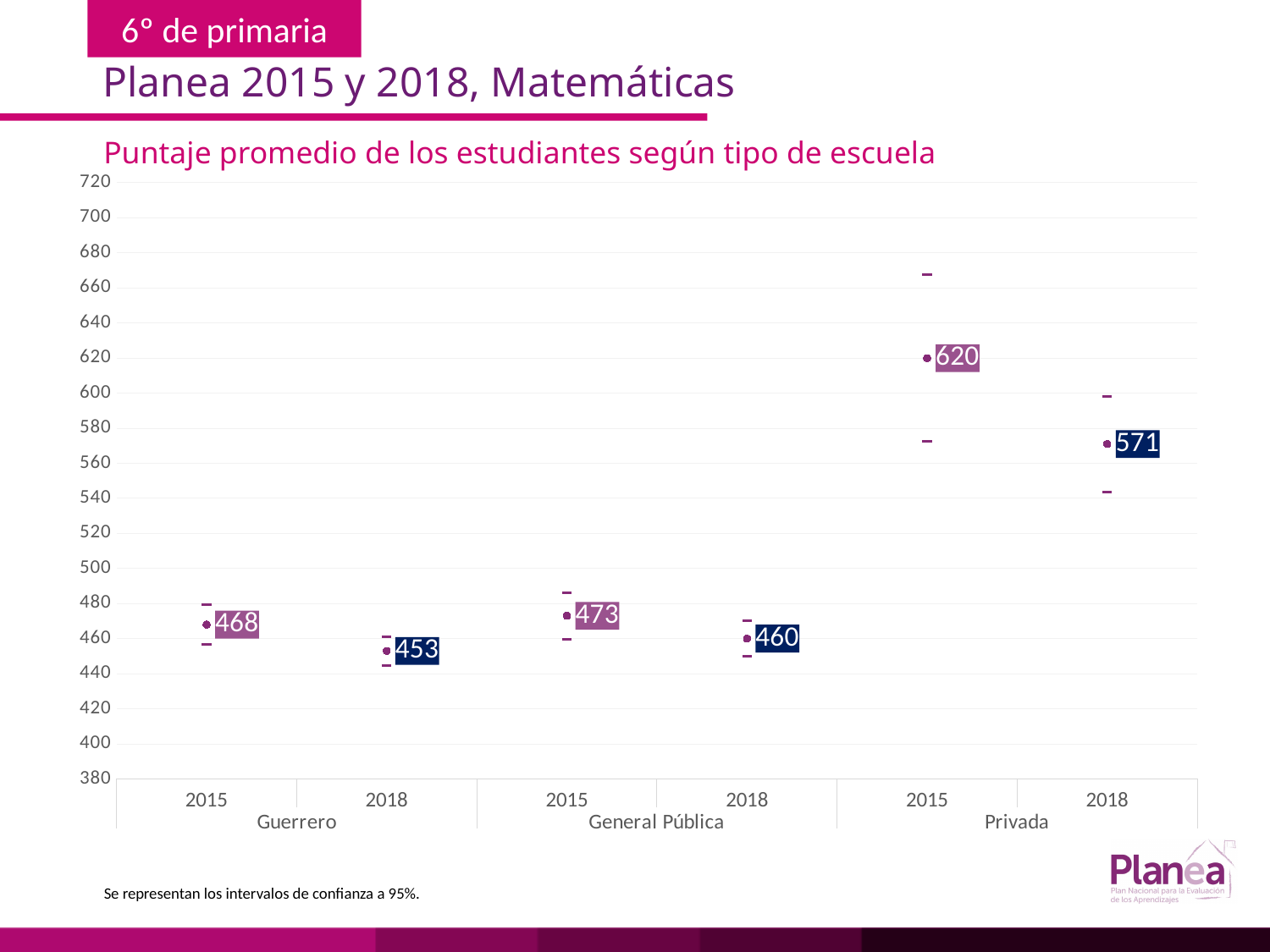
What is the average score for Privada in 2018? 571 What is the average score for Guerrero in 2018? 453 How many data points are plotted on the chart? 6 Which school type and year has the lowest average score? Guerrero 2018 What is the title of the chart? Puntaje promedio de los estudiantes según tipo de escuela Which school type and year has the highest average score? Privada 2015 What is the average score for Guerrero in 2015? 468 Did the average score for Guerrero rise or fall from 2015 to 2018? fall What is the difference between the Privada scores in 2015 and 2018? 49 What is the average score for General Pública in 2015? 473 Which is larger, the Guerrero 2015 score or the General Pública 2015 score? General Pública 2015 What is the difference between the General Pública scores in 2015 and 2018? 13